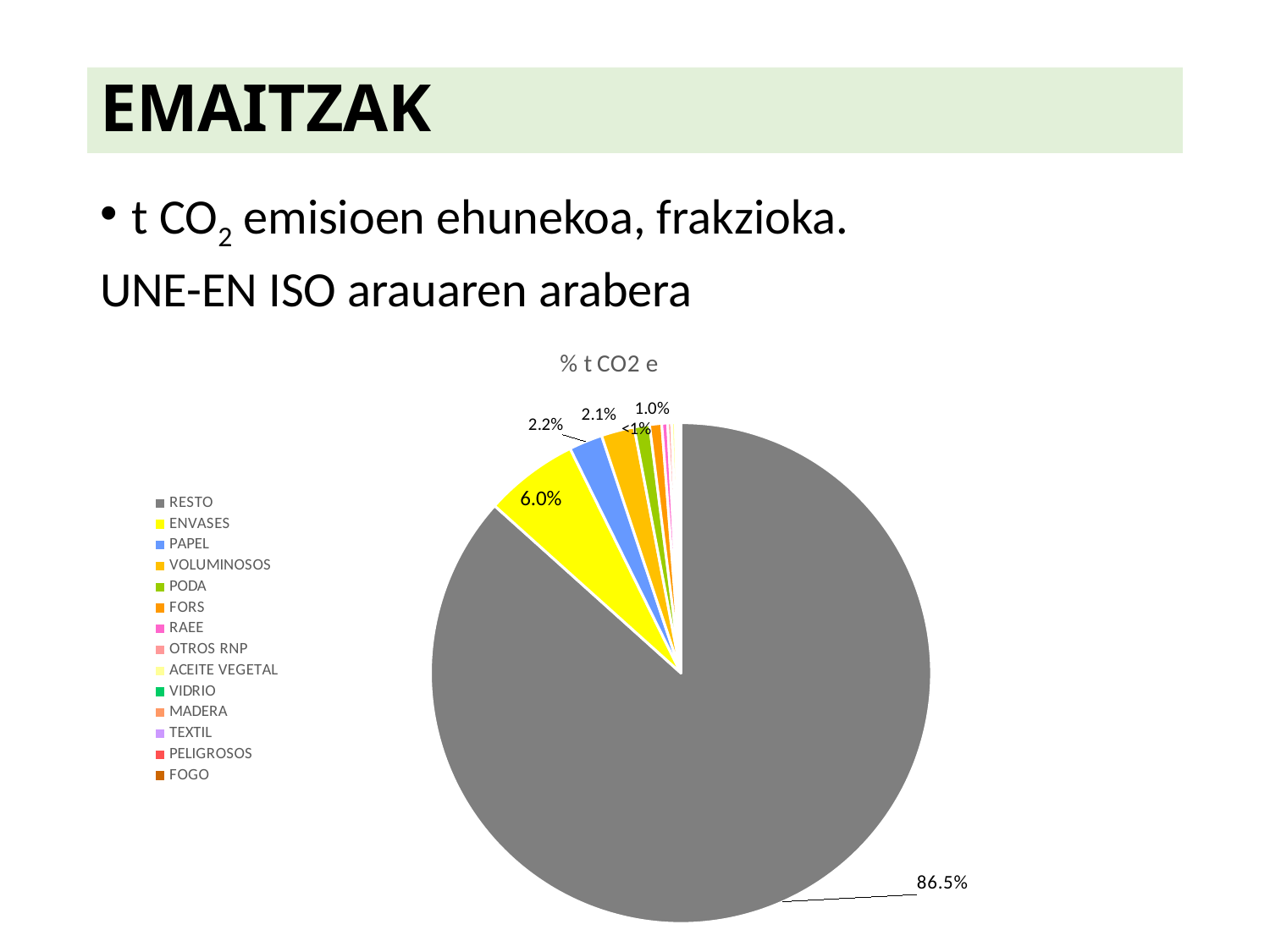
What colour is the RESTO slice? grey Which is larger, the share for PAPEL or the share for VOLUMINOSOS? PAPEL Which category has the largest share of the pie? RESTO Which is larger, the share for ENVASES or the share for PAPEL? ENVASES What percentage is shown for ENVASES? 6.0% What percentage is shown for VOLUMINOSOS? 2.1% What kind of chart is shown on the slide? pie chart What percentage is shown for PAPEL? 2.2% What is the difference in percentage points between RESTO and ENVASES? 80.5 What is the title of the chart? % t CO2 e What percentage of t CO2 e emissions does RESTO account for? 86.5% How many categories does the legend list? 14